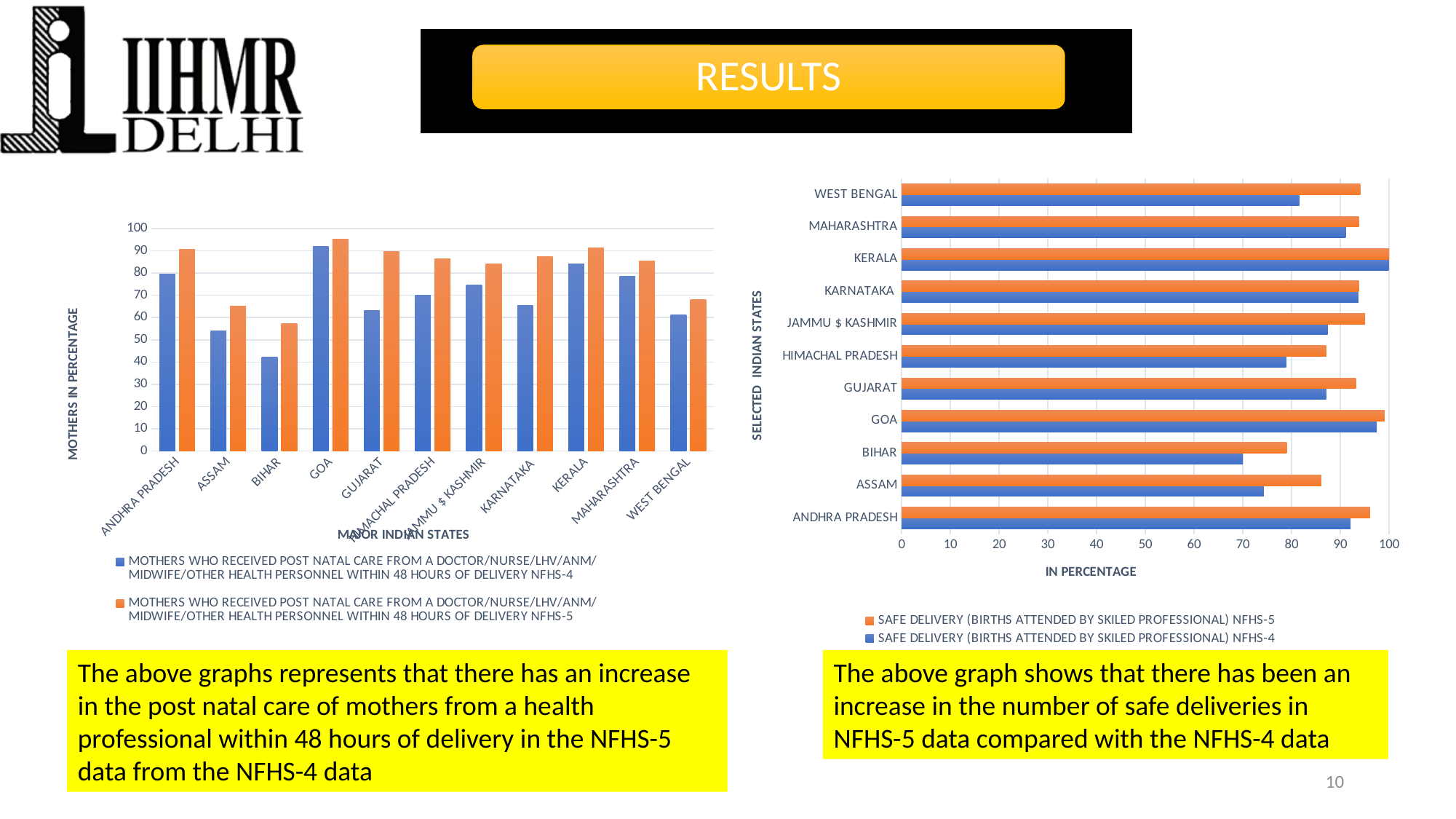
In the left chart, is the NFHS-4 value for Bihar greater or less than 50? less In the left chart, which is larger: the NFHS-4 value for Goa or the NFHS-4 value for Andhra Pradesh? Goa How many series does the legend of the right chart list? 2 How many states are shown on the x axis of the left chart? 11 In the left chart, is the NFHS-4 value for Goa greater or less than 90? greater What kind of chart is the left chart on the slide? Bar chart In the left chart, which state has the lowest NFHS-4 value? Bihar What kind of chart is the right chart on the slide? Bar chart In the right chart, is the NFHS-4 value for Assam greater or less than 80? less In the right chart, which state has the lowest NFHS-4 safe delivery value? Bihar In the left chart, which state has the highest NFHS-5 value? Goa